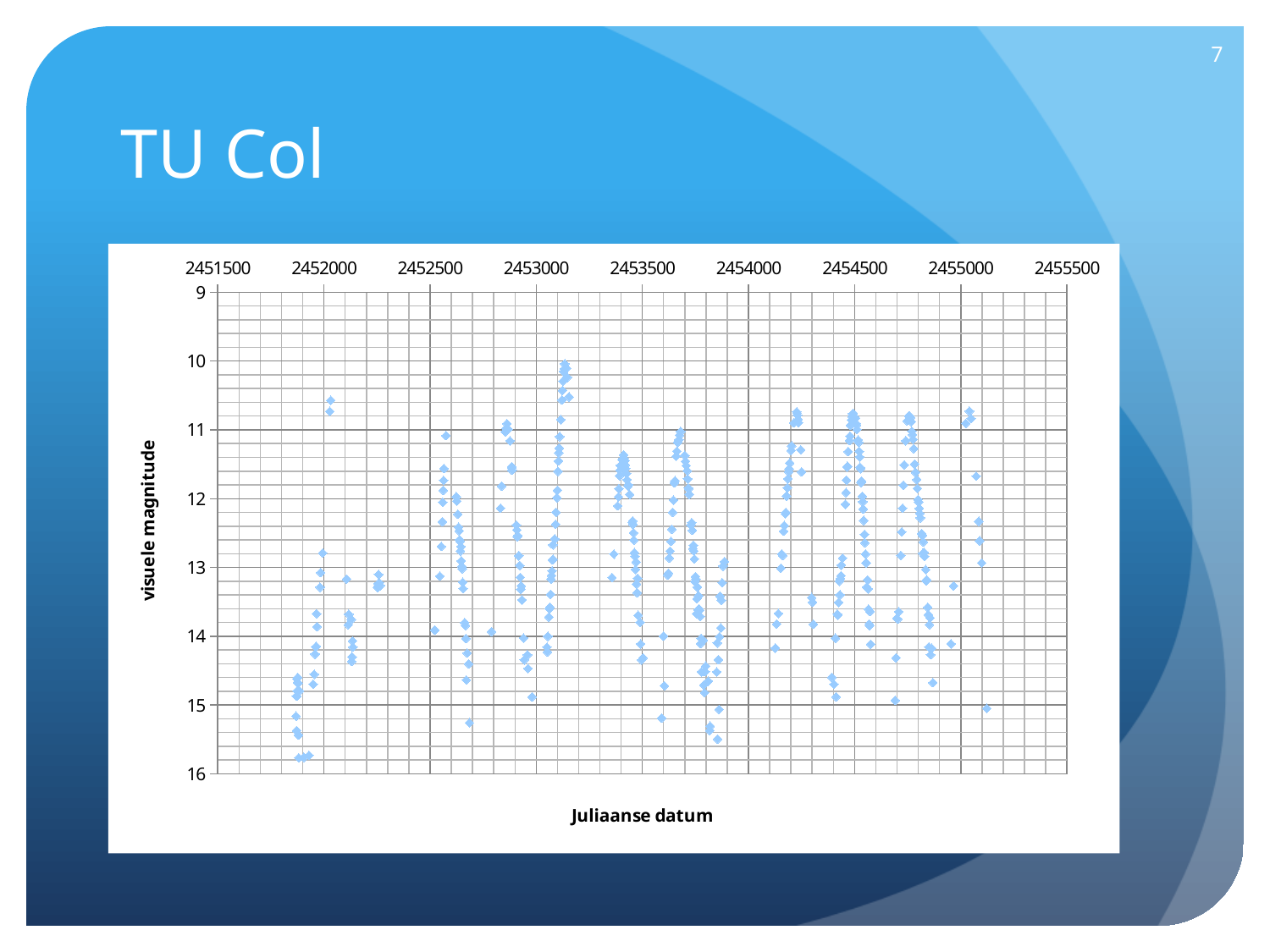
What is the title of the x axis of the chart? Juliaanse datum Is the brightest point in the cluster near Julian date 2454200 greater or less than 12 in magnitude? less What is the title of the y axis of the chart? visuele magnitude Is the brightest (smallest) magnitude plotted on the chart, near Julian date 2453100, greater or less than 11? less Is the brightest point in the cluster near Julian date 2452000 greater or less than 12 in magnitude? less What kind of chart is shown on the slide? scatter chart